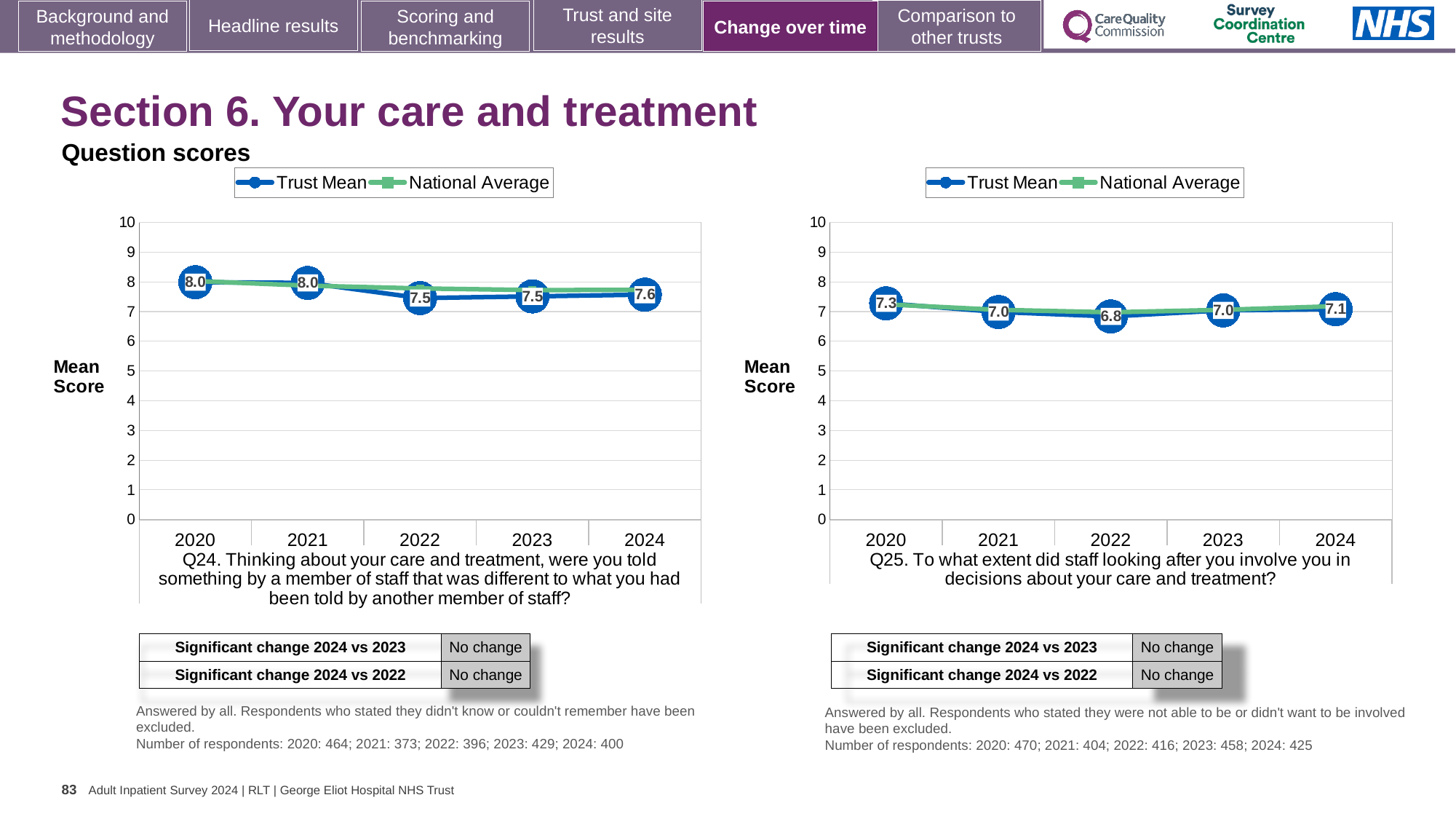
In the Q24 chart (left), what is the difference between the Trust Mean score in 2020 and in 2022? 0.5 In the Q24 chart (left), is the Trust Mean score for 2021 higher or lower than for 2023? higher In the Q25 chart (right), which year has the highest Trust Mean score? 2020 In the Q25 chart (right), is the National Average for 2020 greater or less than 5? greater What kind of chart is the Q25 chart (right)? line chart How many series does the legend of the Q24 chart (left) list? 2 In the Q24 chart (left), what is the Trust Mean score for 2024? 7.6 In the Q24 chart (left), what is the Trust Mean score for 2022? 7.5 In the Q25 chart (right), what is the difference between the Trust Mean score in 2020 and in 2022? 0.5 In the Q25 chart (right), which year has the lowest Trust Mean score? 2022 In the Q25 chart (right), what is the Trust Mean score for 2022? 6.8 In the Q25 chart (right), what is the Trust Mean score for 2020? 7.3